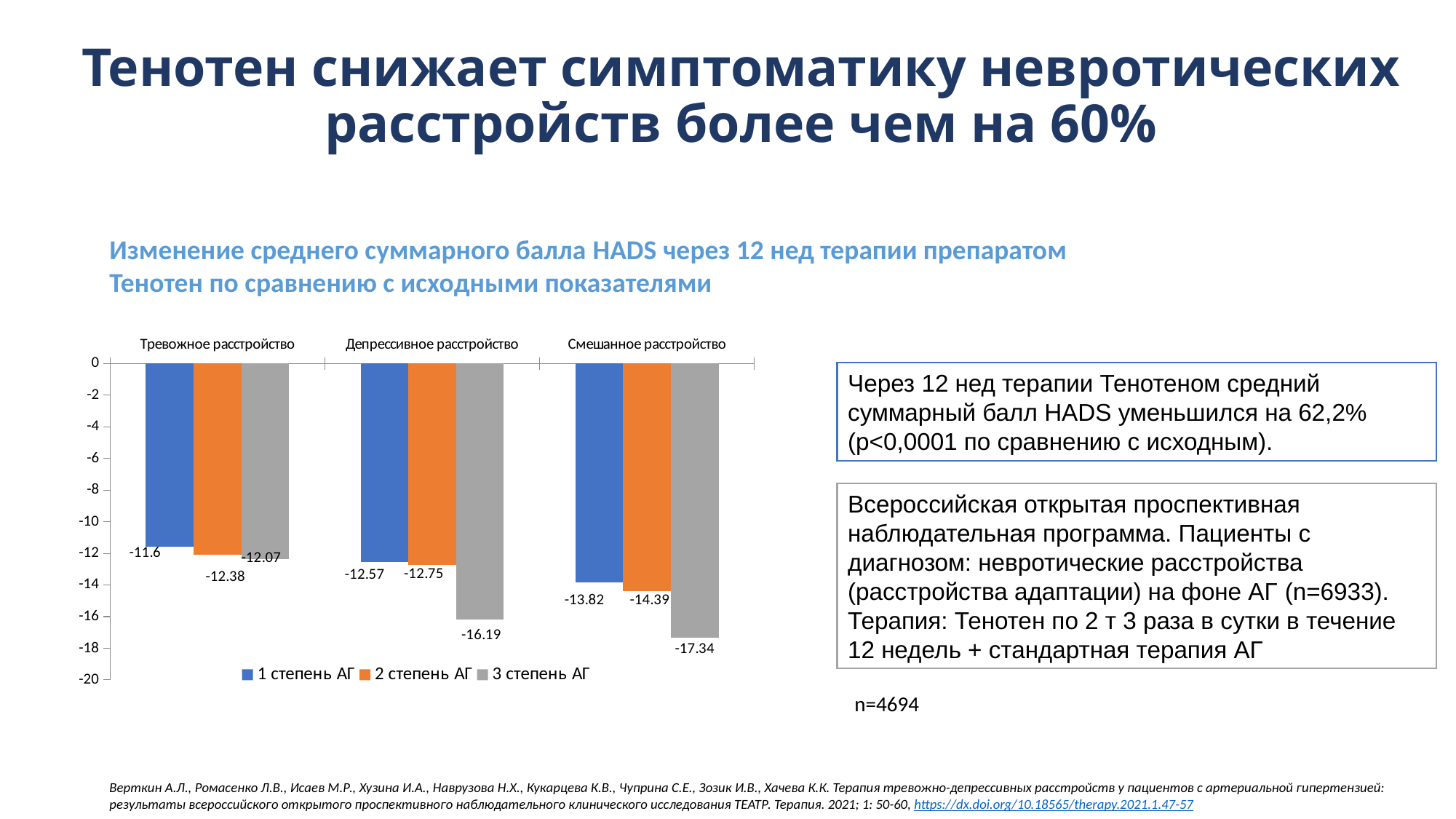
How many series does the chart legend list? 3 Which colour represents 2 степень АГ in the chart legend? Orange What is the difference between the 3 степень АГ and 1 степень АГ values in the Депрессивное расстройство category? 3.62 What is the value for 3 степень АГ in the Депрессивное расстройство category? -16.19 What is the value for 2 степень АГ in the Смешанное расстройство category? -14.39 What is the value for 3 степень АГ in the Смешанное расстройство category? -17.34 Which is more negative: the 2 степень АГ value for Депрессивное расстройство or the 2 степень АГ value for Смешанное расстройство? Смешанное расстройство What is the value for 1 степень АГ in the Тревожное расстройство category? -11.6 How many categories are shown on the x axis of the chart? 3 What type of chart is shown on the slide? Bar chart Which category has the lowest (most negative) value for 3 степень АГ? Смешанное расстройство Which series has the highest (least negative) value in the Тревожное расстройство category? 1 степень АГ